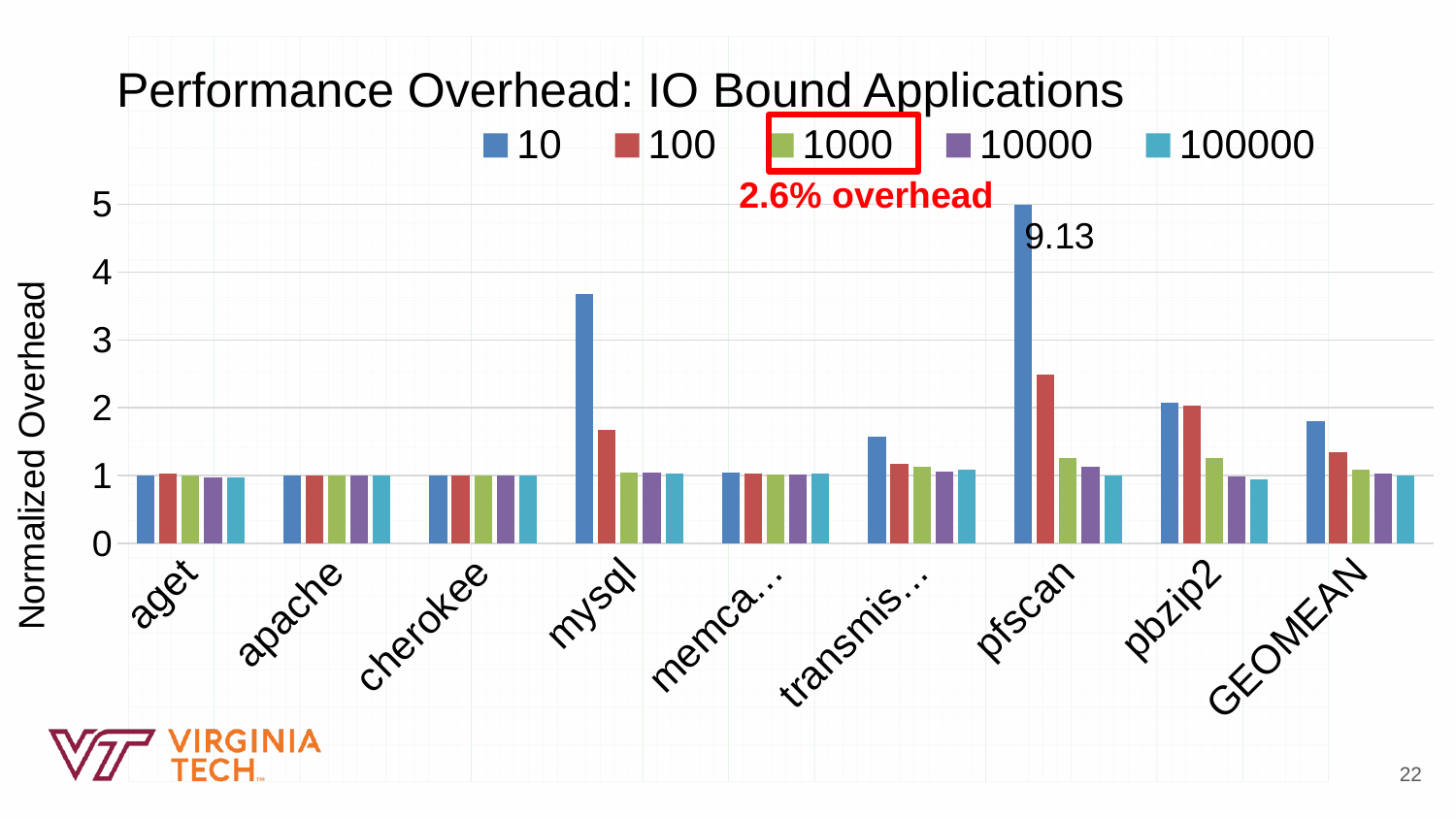
How many categories are shown along the x axis? 9 Which legend entry is highlighted with a red box? 1000 For pfscan, do the bars get taller or shorter going from the 10 series to the 100000 series? shorter Is the value for mysql in the 10 series greater or less than 3? greater What kind of chart is shown on the slide? bar chart Which category has the highest value in the 10 series? pfscan How many series does the legend list? 5 Is the value for pfscan in the 100 series greater or less than 2? greater In the 10 series, which is larger: mysql or pbzip2? mysql Is the value for GEOMEAN in the 10 series greater or less than 2? less In the 100 series, which is larger: pfscan or mysql? pfscan What is the value for pfscan in the 10 series? 9.13